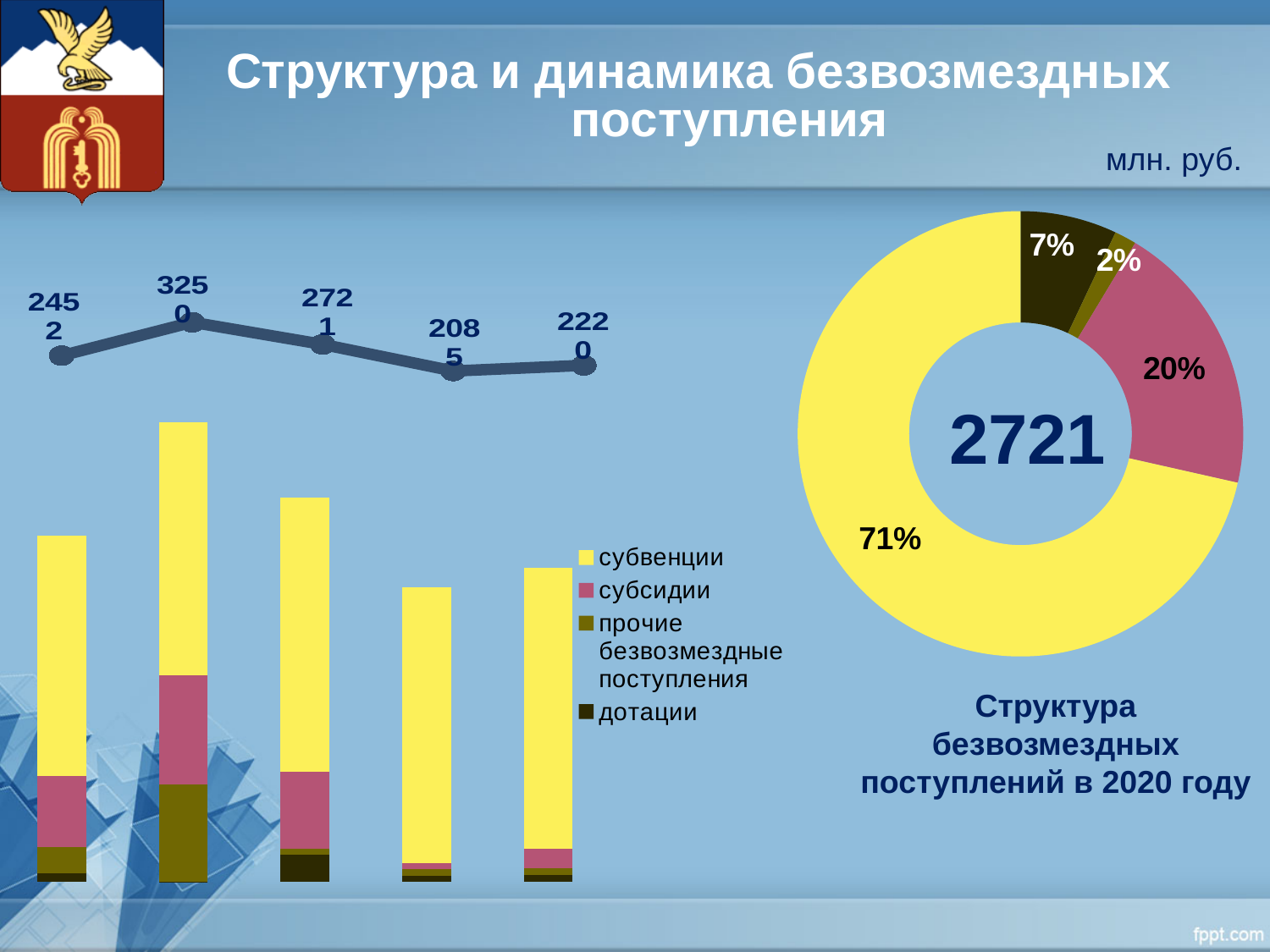
What number is printed in the centre of the donut chart on the right? 2721 In the chart on the left, what is the highest value labelled on the line? 3250 In the donut chart 'Структура безвозмездных поступлений в 2020 году', which category has the smallest share? прочие безвозмездные поступления How many series does the legend of the stacked bar chart on the left list? 4 In the donut chart 'Структура безвозмездных поступлений в 2020 году', what share is shown for субвенции? 71% In the donut chart on the right, by how many percentage points does the share of субвенции exceed the share of субсидии? 51 percentage points In the chart on the left, what is the lowest value labelled on the line? 2085 In the donut chart 'Структура безвозмездных поступлений в 2020 году', which category has the largest share? субвенции In the donut chart 'Структура безвозмездных поступлений в 2020 году', what share is shown for прочие безвозмездные поступления? 2% In the donut chart 'Структура безвозмездных поступлений в 2020 году', what share is shown for дотации? 7% How many stacked bars are plotted in the chart on the left? 5